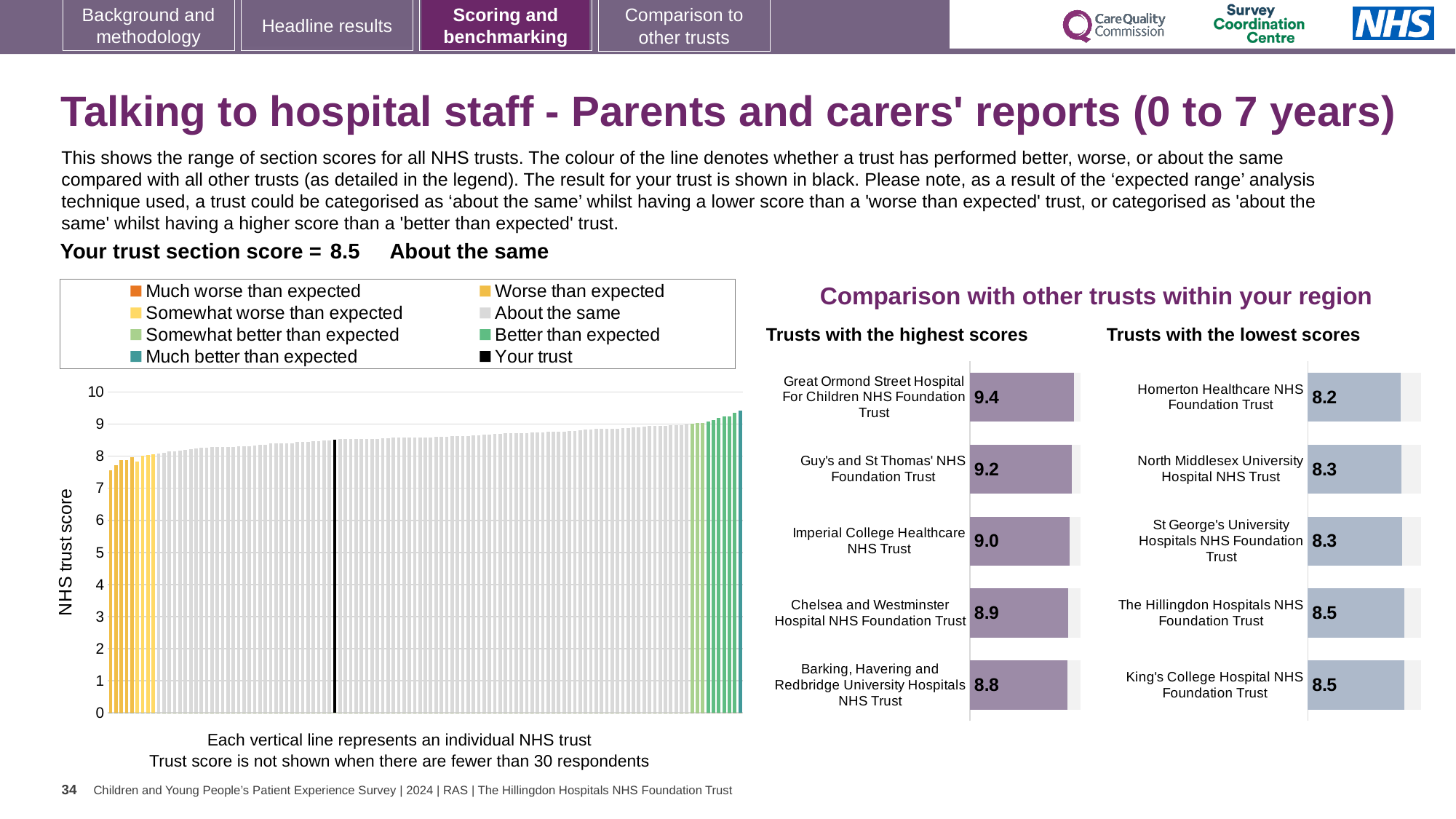
How many entries does the legend of the main chart on the left list? 8 In the 'Trusts with the highest scores' chart, what is the score for Great Ormond Street Hospital For Children NHS Foundation Trust? 9.4 In the 'Trusts with the highest scores' chart, what is the difference between the scores of Great Ormond Street Hospital For Children NHS Foundation Trust and Barking, Havering and Redbridge University Hospitals NHS Trust? 0.6 What is the label on the vertical axis of the main chart on the left? NHS trust score In the 'Trusts with the lowest scores' chart, what is the score for Homerton Healthcare NHS Foundation Trust? 8.2 How many trusts are shown in the 'Trusts with the highest scores' chart? 5 In the 'Trusts with the lowest scores' chart, what is the score for The Hillingdon Hospitals NHS Foundation Trust? 8.5 In the 'Trusts with the highest scores' chart, which has the larger score: Guy's and St Thomas' NHS Foundation Trust or Imperial College Healthcare NHS Trust? Guy's and St Thomas' NHS Foundation Trust In the 'Trusts with the lowest scores' chart, which trust has the lowest score? Homerton Healthcare NHS Foundation Trust In the 'Trusts with the highest scores' chart, which trust has the highest score? Great Ormond Street Hospital For Children NHS Foundation Trust What kind of chart is the main chart on the left showing all NHS trusts? Bar chart In the main chart on the left, what is the section score for your trust? 8.5